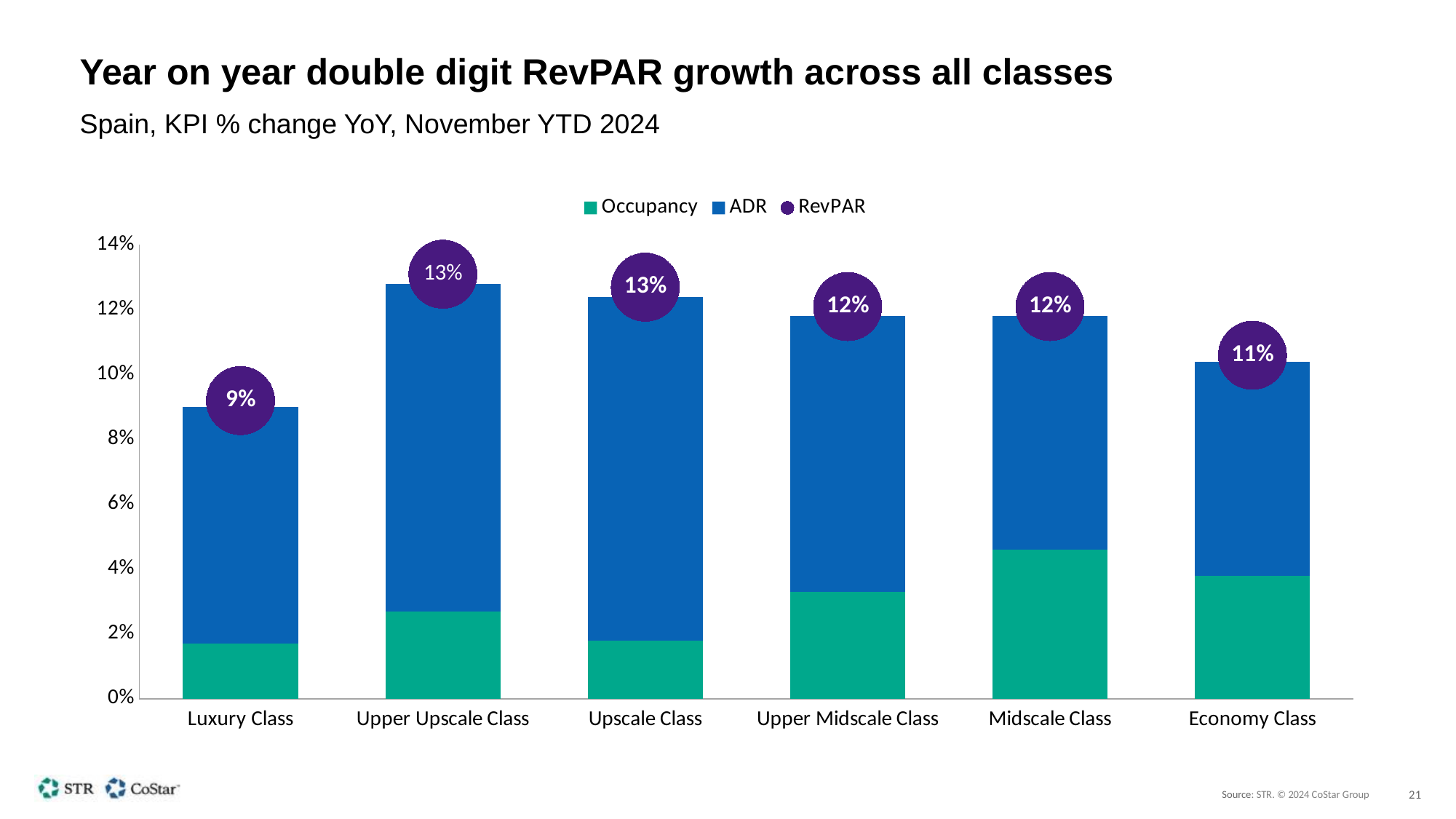
What kind of chart is shown on the slide? Stacked bar chart Which has a larger RevPAR % change, Luxury Class or Economy Class? Economy Class How many series does the legend list? 3 How many hotel classes are shown on the x axis? 6 What is the RevPAR % change for Economy Class? 11% What is the title of the chart? Year on year double digit RevPAR growth across all classes Which class has the lowest RevPAR % change? Luxury Class Is the Occupancy value for Midscale Class greater or less than 4%? greater What is the RevPAR % change for Upper Midscale Class? 12% What is the difference in RevPAR % change between Upper Upscale Class and Luxury Class? 4 percentage points What is the RevPAR % change for Luxury Class? 9% Is the Occupancy value for Luxury Class greater or less than 2%? less